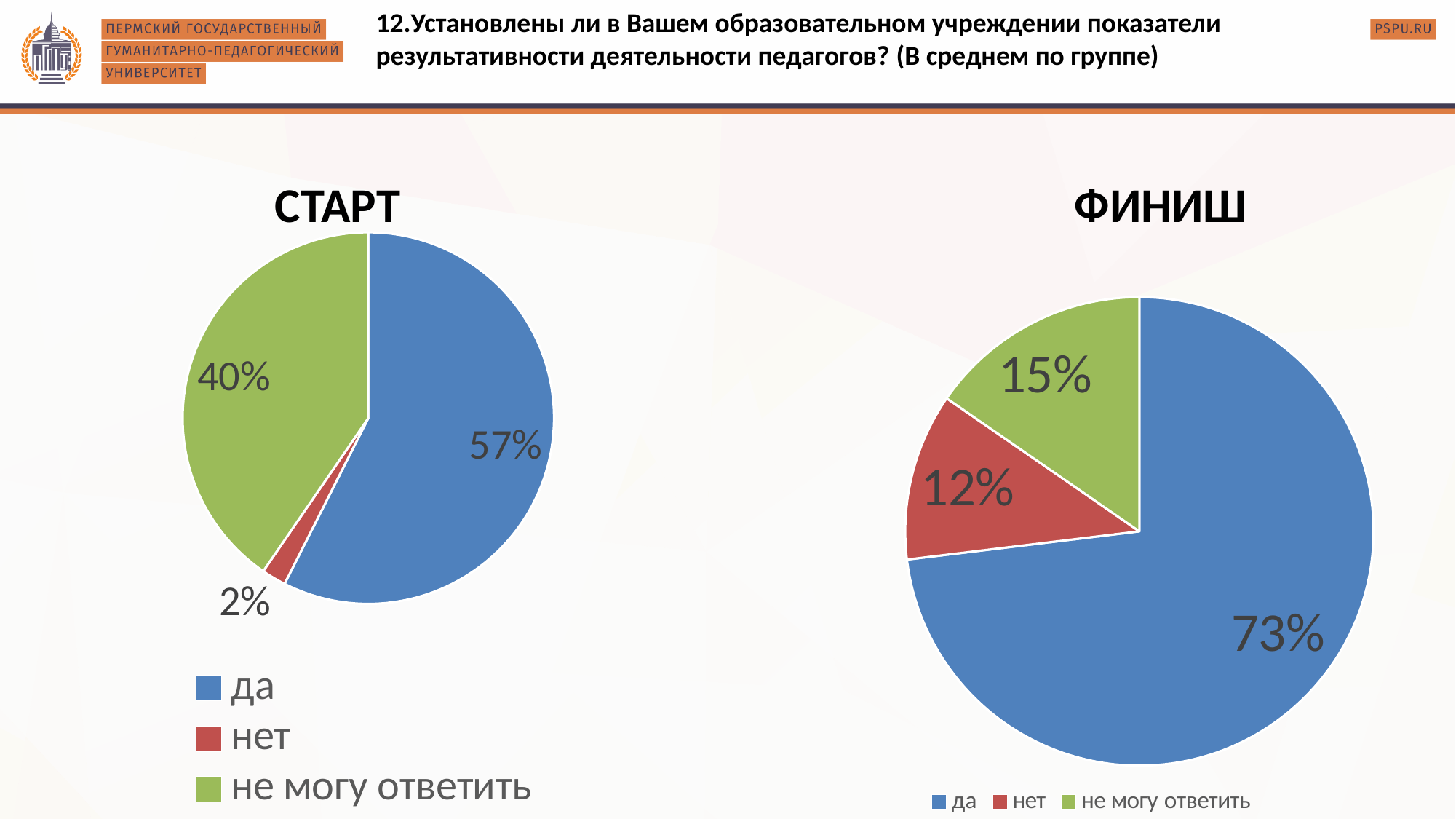
In the ФИНИШ pie chart, which answer has the largest share? да How many categories does the legend of the СТАРТ pie chart list? 3 In the СТАРТ pie chart, what share of respondents answered "не могу ответить"? 40% In the СТАРТ pie chart, what share of respondents answered "да"? 57% In the ФИНИШ pie chart, what share of respondents answered "нет"? 12% In the ФИНИШ pie chart, what share of respondents answered "не могу ответить"? 15% In the ФИНИШ pie chart, what share of respondents answered "да"? 73% In the СТАРТ pie chart, which answer has the smallest share? нет In the СТАРТ pie chart, what share of respondents answered "нет"? 2% What type of chart is used for the ФИНИШ data? Pie chart Which chart has the larger share for "не могу ответить", СТАРТ or ФИНИШ? СТАРТ What is the difference between the "да" share in the ФИНИШ chart and the "да" share in the СТАРТ chart? 16%